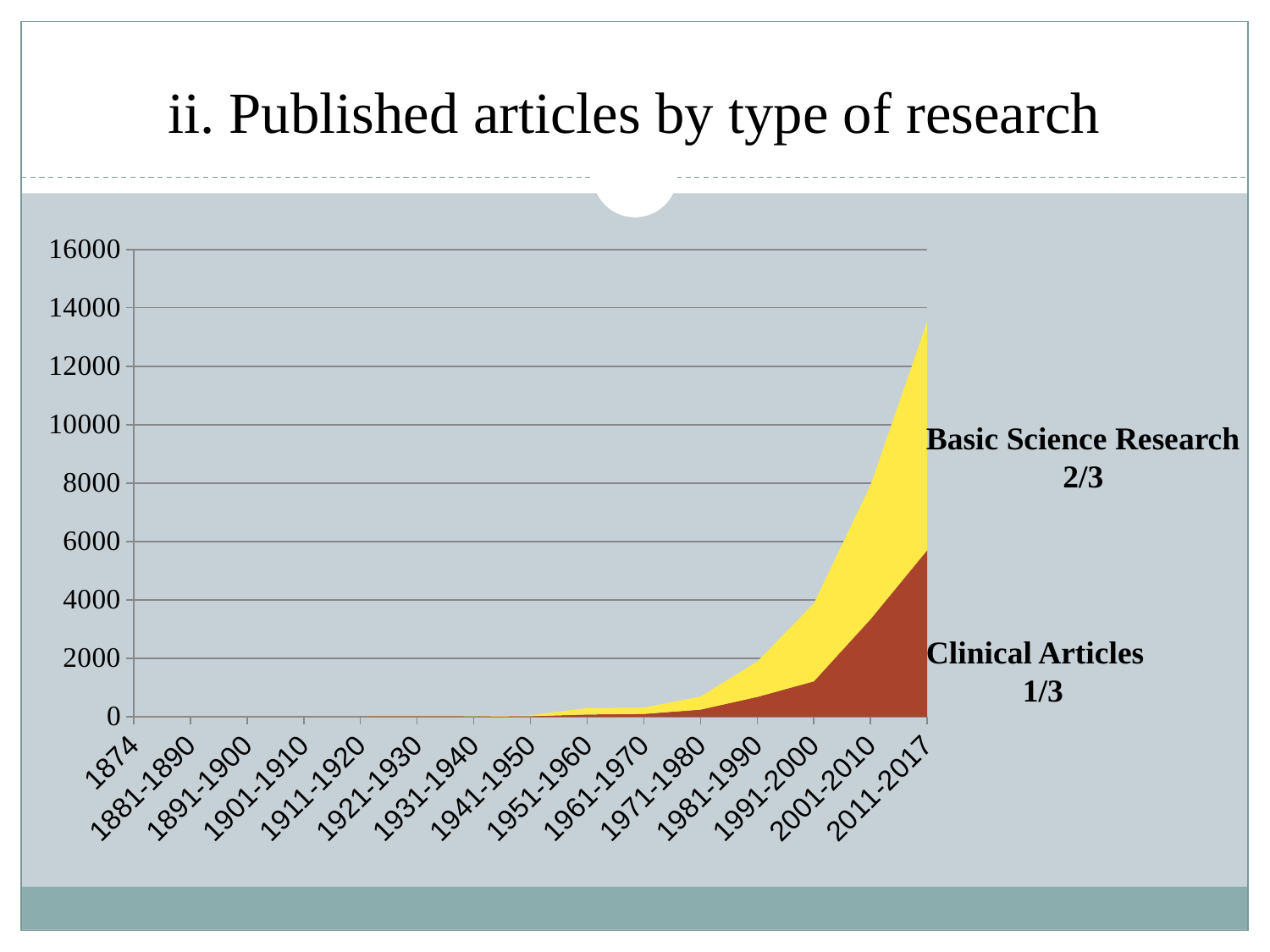
In 2011-2017, which is larger: Basic Science Research or Clinical Articles? Basic Science Research How many series are plotted in the chart? 2 How many time periods are shown along the x axis of the chart? 15 Do the values in the chart generally rise or fall along the x axis from 1874 to 2011-2017? Rise What colour represents Clinical Articles in the chart? Dark red Which time period has the highest total number of published articles? 2011-2017 Is the total number of published articles for 2011-2017 greater or less than 12000? greater Is the total number of published articles for 2011-2017 greater or less than 14000? less What fraction of published articles does the slide attribute to Basic Science Research? 2/3 What kind of chart is shown on the slide? Area chart Is the value for Clinical Articles in 1991-2000 greater or less than 2000? less